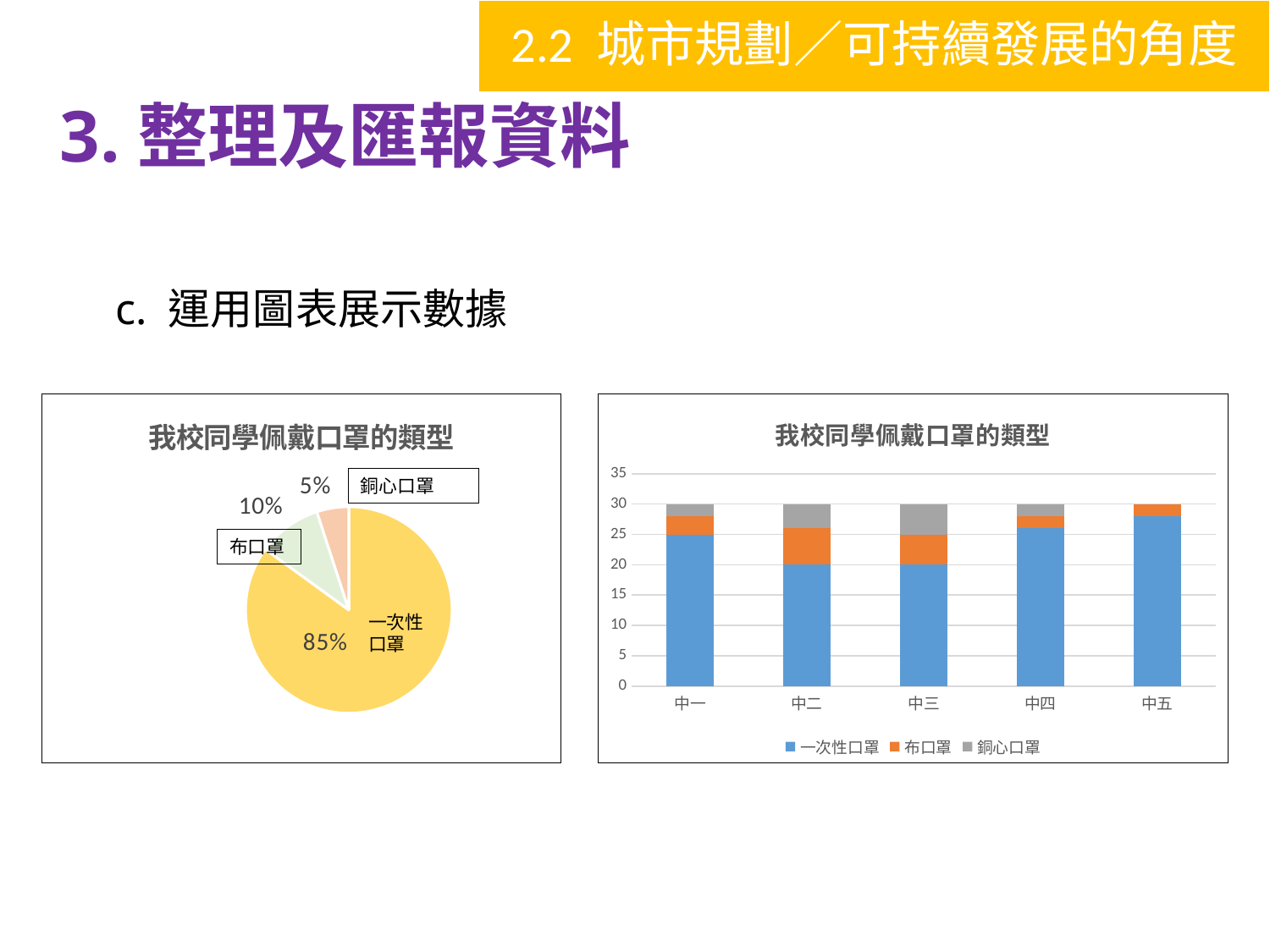
In the pie chart on the left, what is the difference in percentage points between 一次性口罩 and 布口罩? 75 In the bar chart on the right, how many categories are shown on the x axis? 5 In the pie chart on the left, what share of students wear 一次性口罩? 85% In the pie chart on the left, what percentage is shown for 銅心口罩? 5% What kind of chart is the chart on the right of the slide? Stacked bar chart In the bar chart on the right, what is the total height of the stacked bar for 中一? 30 In the bar chart on the right, is the value of 一次性口罩 for 中五 greater or less than 25? greater In the pie chart on the left, what percentage is shown for 布口罩? 10% In the bar chart on the right, which category has the largest 布口罩 segment, 中二 or 中五? 中二 In the bar chart on the right, how many series does the legend list? 3 In the pie chart on the left, which mask type has the smallest slice? 銅心口罩 In the pie chart on the left, how many slices are there? 3